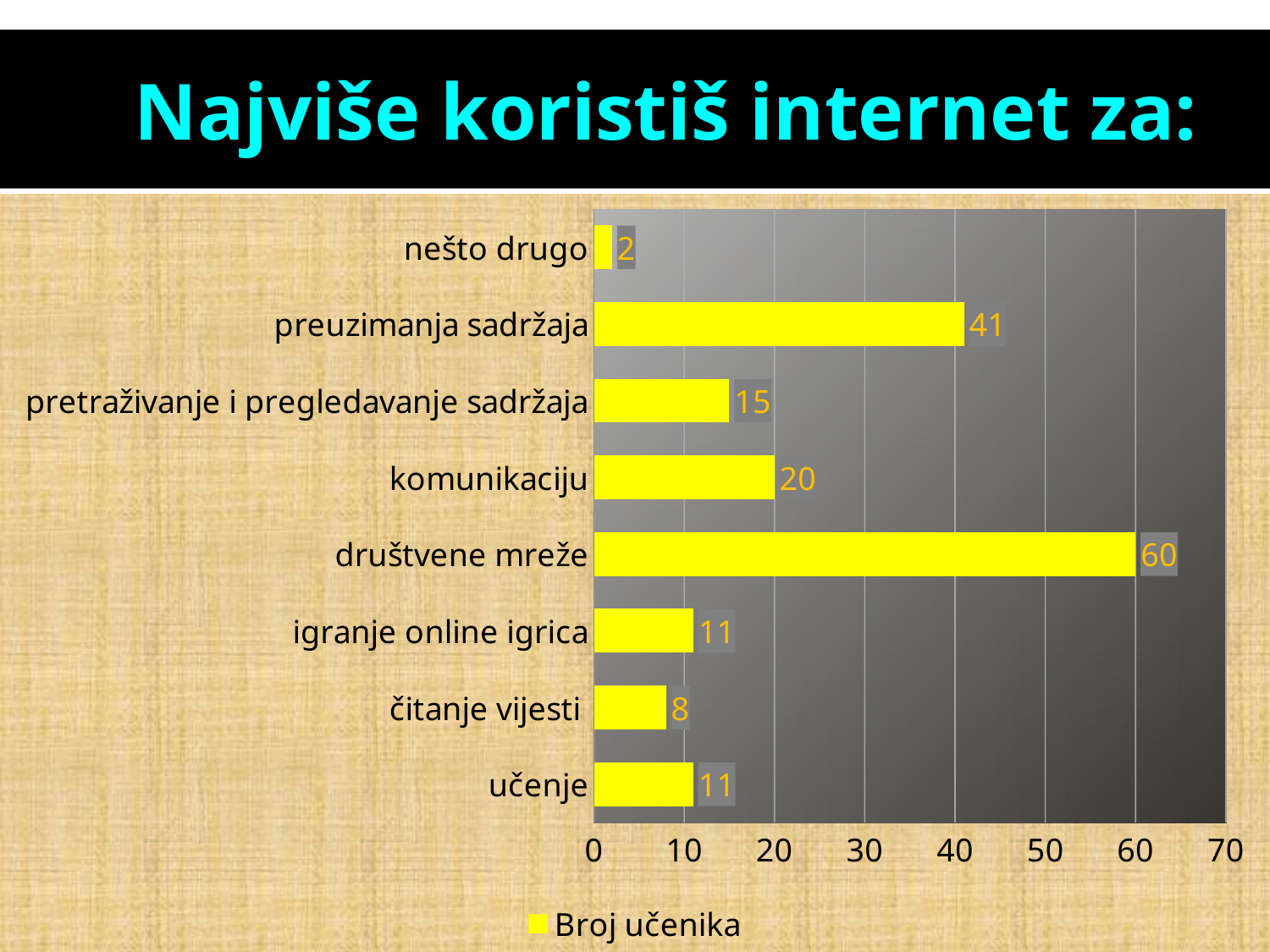
What is the name of the series shown in the legend? Broj učenika What is the value for društvene mreže? 60 How many categories are shown in the chart? 8 What is the difference between the values for društvene mreže and preuzimanja sadržaja? 19 What is the value for čitanje vijesti? 8 Which category has the highest value? društvene mreže What kind of chart is shown on the slide? bar chart Is the value for preuzimanja sadržaja greater or less than 30? greater Which is larger, the value for komunikaciju or the value for pretraživanje i pregledavanje sadržaja? komunikaciju How many series does the legend list? 1 Which category has the lowest value? nešto drugo What is the value for preuzimanja sadržaja? 41